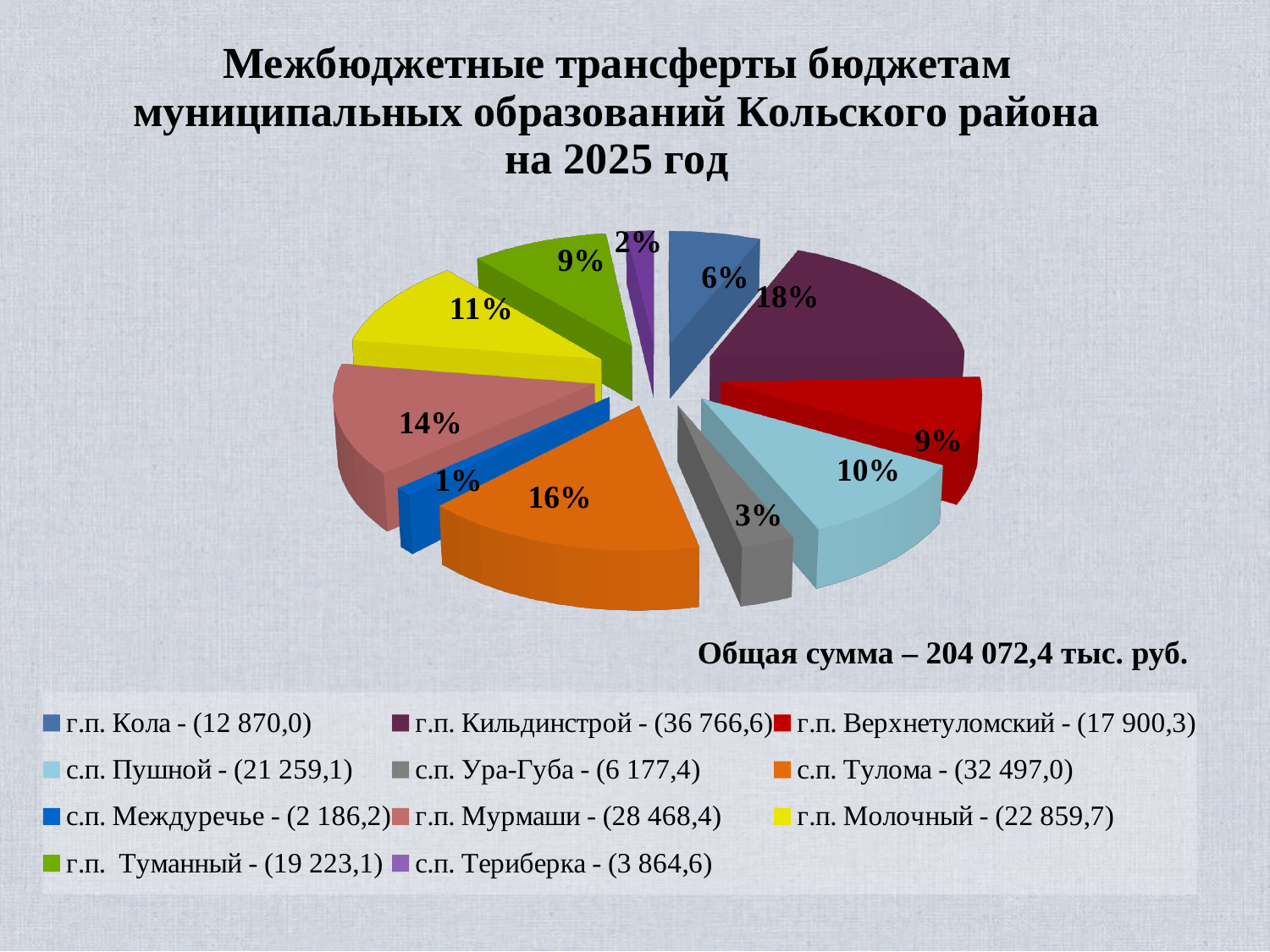
What is the difference in percentage points between the shares of г.п. Кильдинстрой and г.п. Кола? 12 What amount is listed in the legend for г.п. Кильдинстрой? 36 766,6 Which municipality has the smallest share of the pie? с.п. Междуречье What share of the pie does с.п. Ура-Губа have? 3% Which municipality has the largest share of the pie? г.п. Кильдинстрой How many slices does the pie chart have? 11 What amount is listed in the legend for с.п. Териберка? 3 864,6 What total sum is stated on the slide? 204 072,4 тыс. руб. What share of the pie does с.п. Тулома have? 16% Which has a larger share: г.п. Молочный or с.п. Пушной? г.п. Молочный What kind of chart is shown on the slide? pie chart What share of the pie does г.п. Мурмаши have? 14%